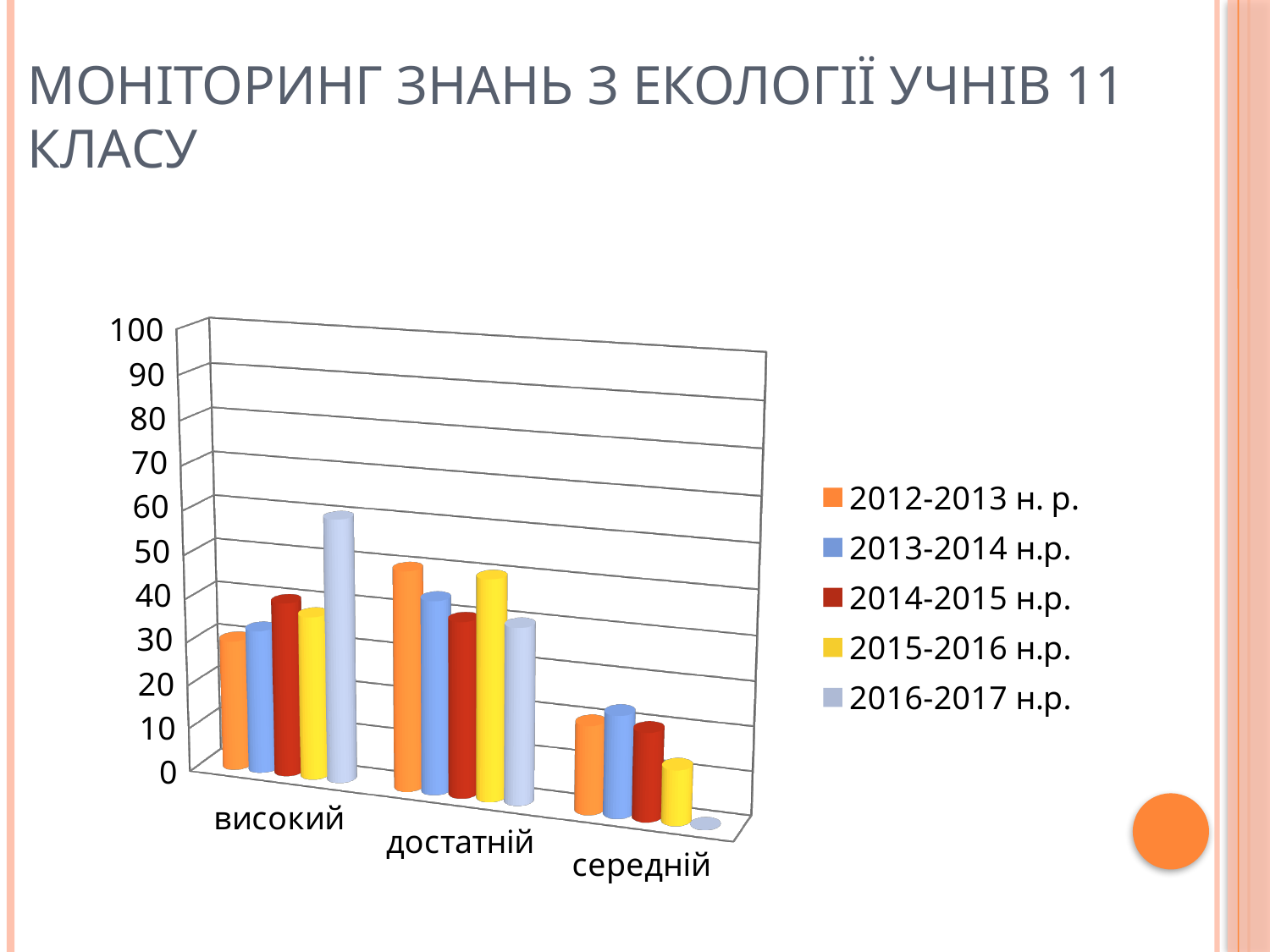
How many series does the chart's legend list? 5 How many categories are shown on the x axis of the chart? 3 What kind of chart is shown on the slide? bar chart Is the value for 2016-2017 н.р. in the category високий greater or less than 50? greater Which series has the highest value for the category високий? 2016-2017 н.р. Which series is shown in orange in the chart's legend? 2012-2013 н. р. Is the value for 2016-2017 н.р. in the category середній greater or less than 10? less Is the value for 2012-2013 н. р. in the category достатній greater or less than 40? greater Which series has the lowest value for the category середній? 2016-2017 н.р. For the series 2016-2017 н.р., which category has the larger value: високий or достатній? високий For the series 2015-2016 н.р., which category has the larger value: достатній or середній? достатній What is the title of the slide containing the chart? МОНІТОРИНГ ЗНАНЬ З ЕКОЛОГІЇ УЧНІВ 11 КЛАСУ